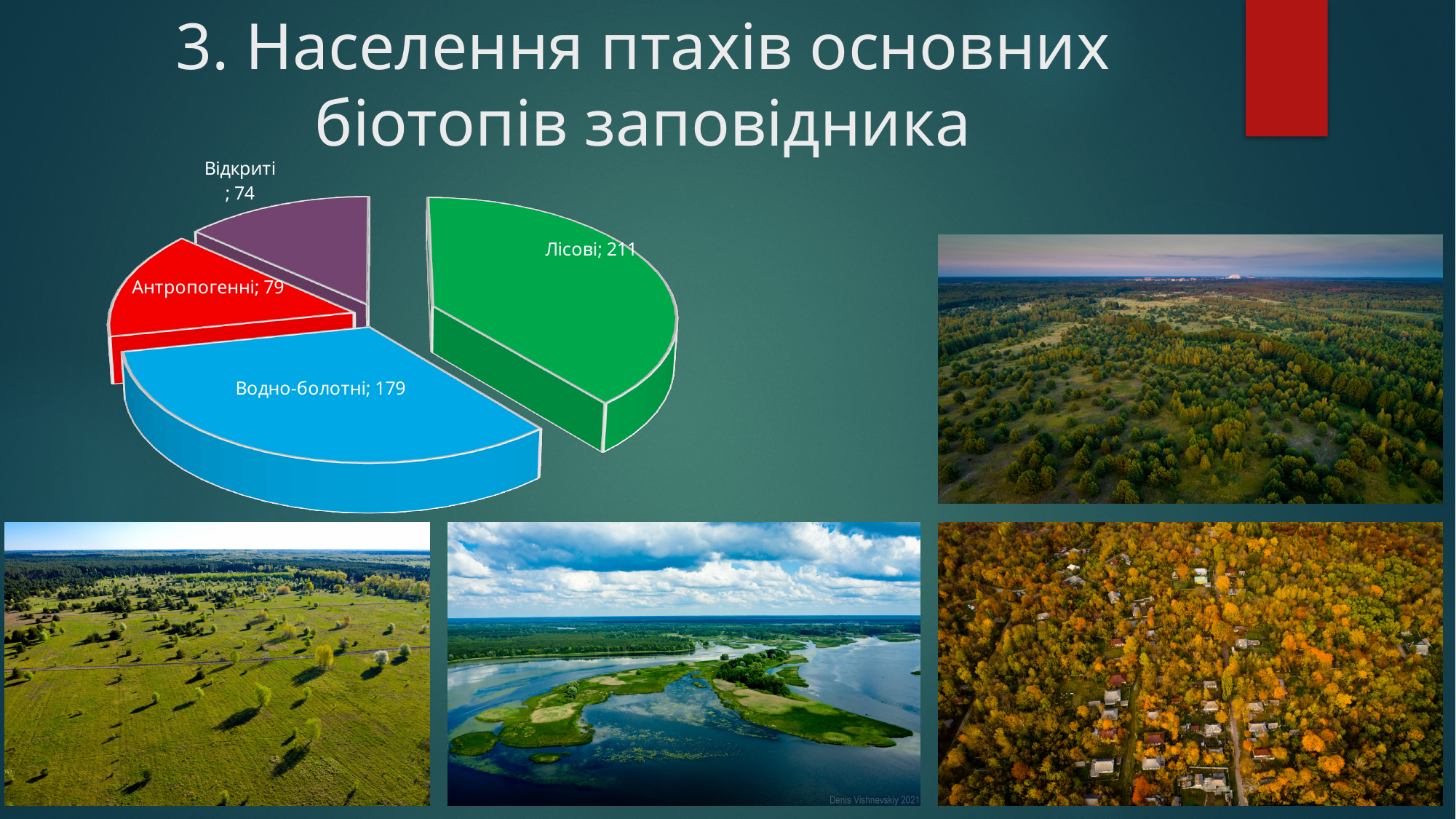
Which is larger, the value for Антропогенні or the value for Відкриті? Антропогенні What is the difference between the values for Лісові and Водно-болотні? 32 What is the value for Антропогенні in the pie chart? 79 What is the value for Лісові in the pie chart? 211 What is the value for Водно-болотні in the pie chart? 179 What is the value for Відкриті in the pie chart? 74 What colour is the Лісові slice in the pie chart? Green Which category has the smallest slice in the pie chart? Відкриті Which category has the largest slice in the pie chart? Лісові What type of chart is shown on the slide? Pie chart What is the total of all four values in the pie chart? 543 How many slices does the pie chart have? 4